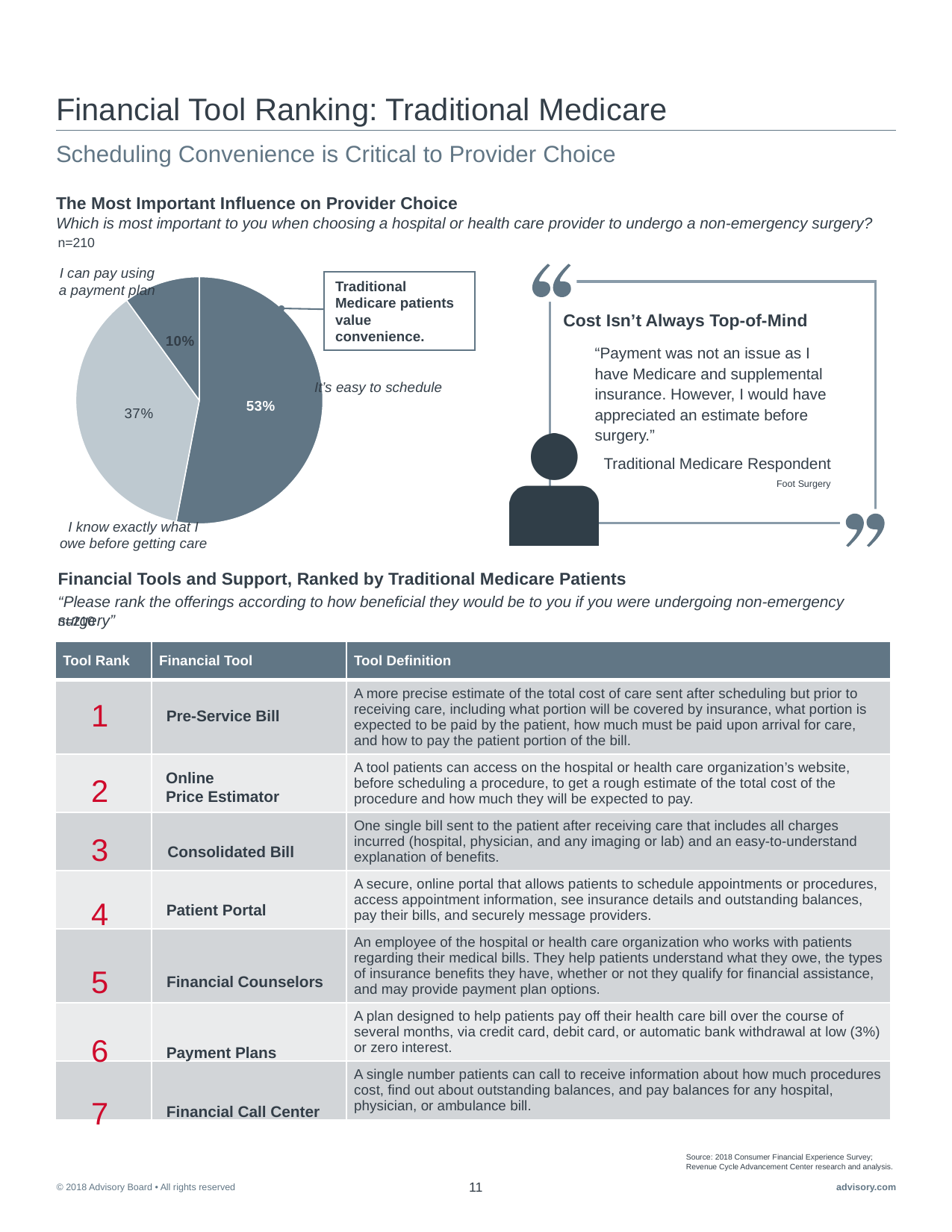
Which response has the smallest slice of the pie chart? I can pay using a payment plan Which response has the largest slice of the pie chart? It's easy to schedule What is the difference in percentage points between "It's easy to schedule" and "I know exactly what I owe before getting care"? 16 What share of respondents chose "I can pay using a payment plan"? 10% How many slices does the pie chart have? 3 Which is larger: the share for "I know exactly what I owe before getting care" or the share for "I can pay using a payment plan"? I know exactly what I owe before getting care What is the title of the pie chart? The Most Important Influence on Provider Choice What share of respondents chose "It's easy to schedule" as the most important influence on provider choice? 53% What kind of chart is used to show the most important influence on provider choice? pie chart What is the sample size (n) shown for the pie chart? n=210 What share of respondents chose "I know exactly what I owe before getting care"? 37% What is the difference in percentage points between "I know exactly what I owe before getting care" and "I can pay using a payment plan"? 27